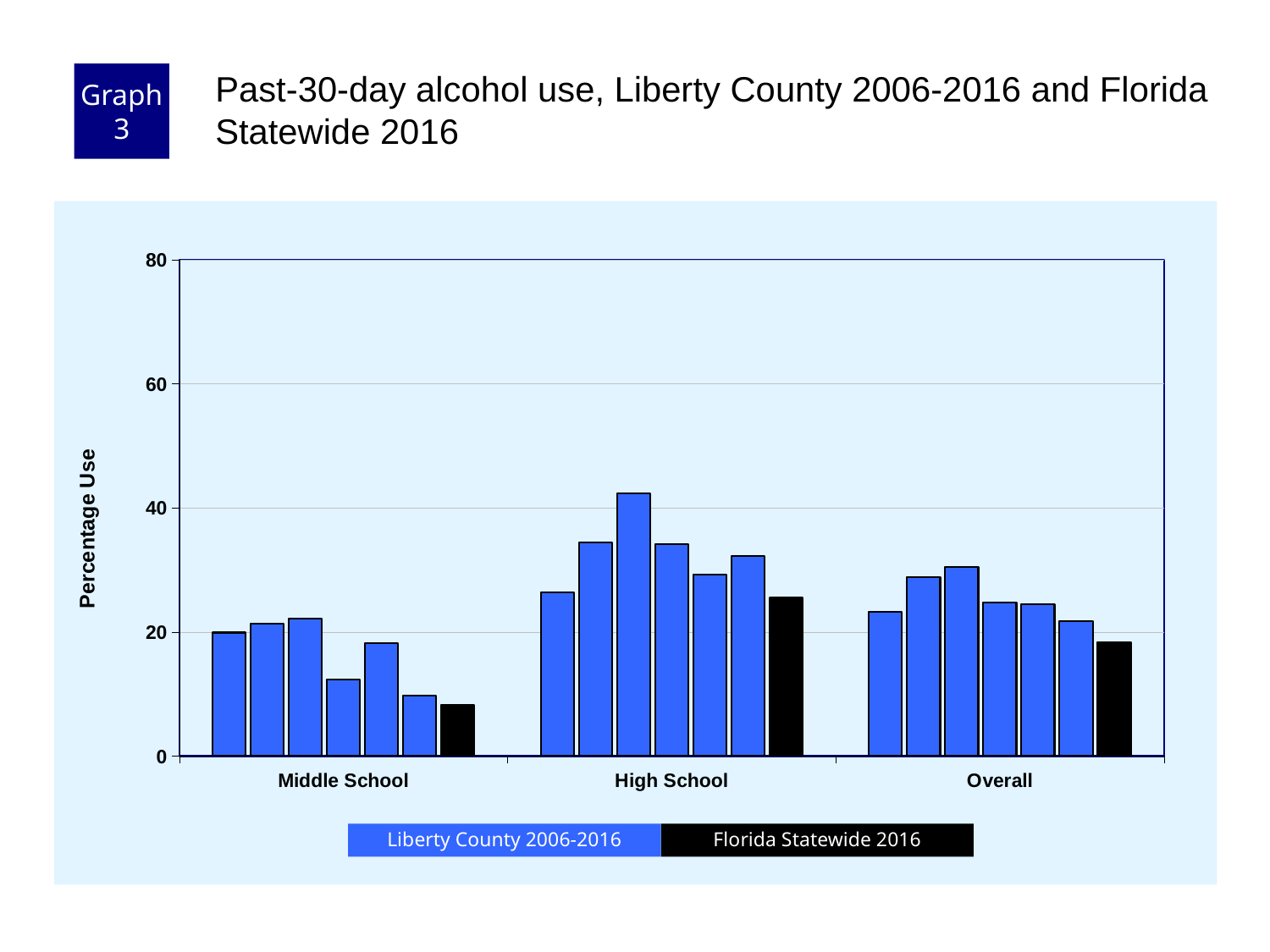
Which category has the highest Florida Statewide 2016 value? High School Is the Florida Statewide 2016 value for Overall greater or less than 20? less Which is larger, the Florida Statewide 2016 value for High School or for Middle School? High School What is the label of the y axis? Percentage Use How many series does the legend list? 2 Which category has the lowest Florida Statewide 2016 value? Middle School How many categories are shown on the x axis? 3 Is the Florida Statewide 2016 value for High School greater or less than 20? greater What colour are the Florida Statewide 2016 bars? black Is the Florida Statewide 2016 value for Middle School greater or less than 20? less What kind of chart is shown on the slide? bar chart